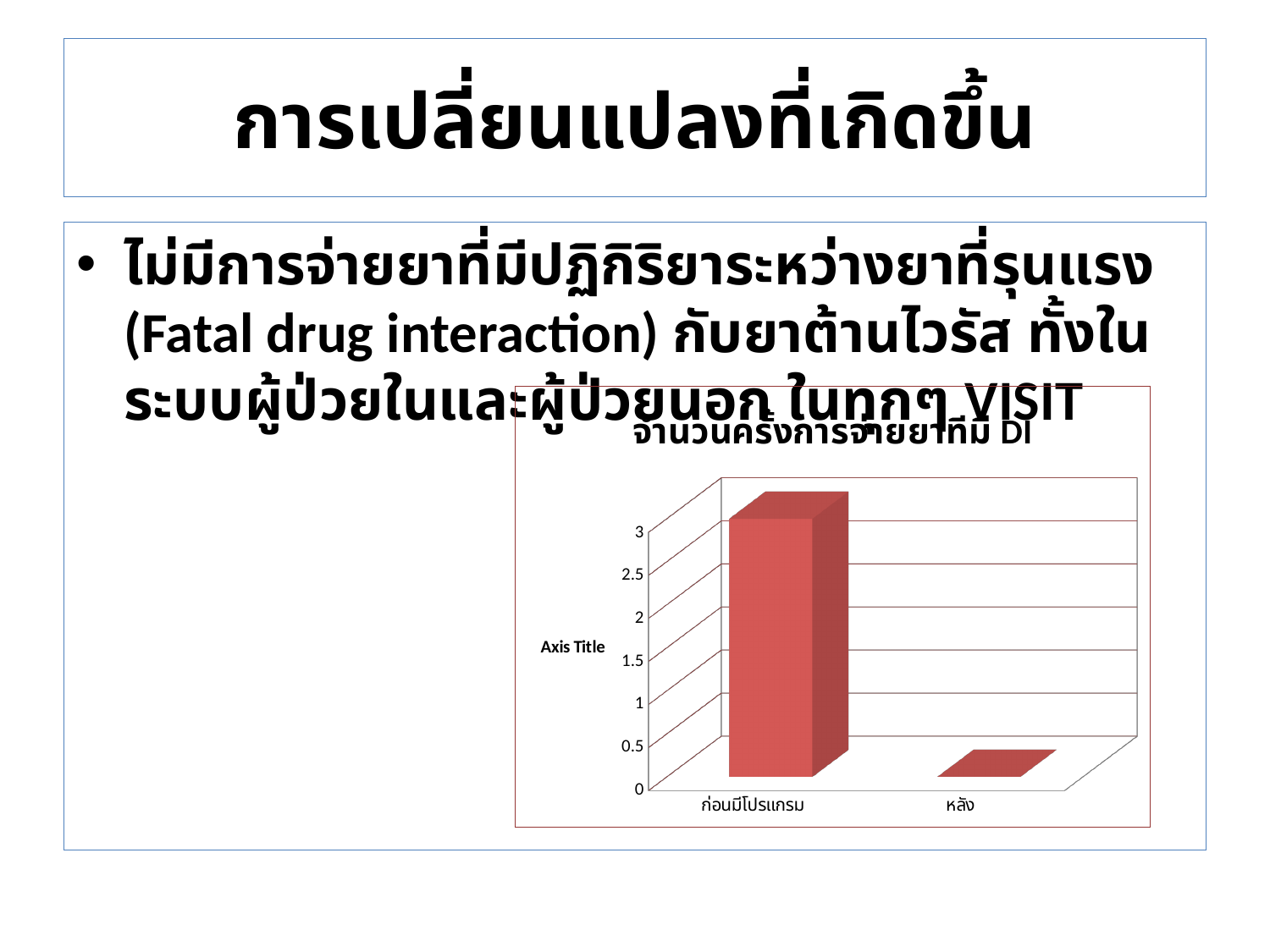
What is the label shown on the vertical axis of the chart? Axis Title Which category has the lowest value in the chart? หลัง Do the values rise or fall from ก่อนมีโปรแกรม to หลัง? fall What is the highest tick value shown on the vertical axis of the chart? 3 What is the value for หลัง in the chart? 0 Is the value for หลัง greater or less than 1? less What kind of chart is shown on the slide? bar chart Is the value for ก่อนมีโปรแกรม greater or less than 2? greater Which is larger, the value for ก่อนมีโปรแกรม or the value for หลัง? ก่อนมีโปรแกรม How many categories are shown on the x axis of the chart? 2 Which category has the highest value in the chart? ก่อนมีโปรแกรม